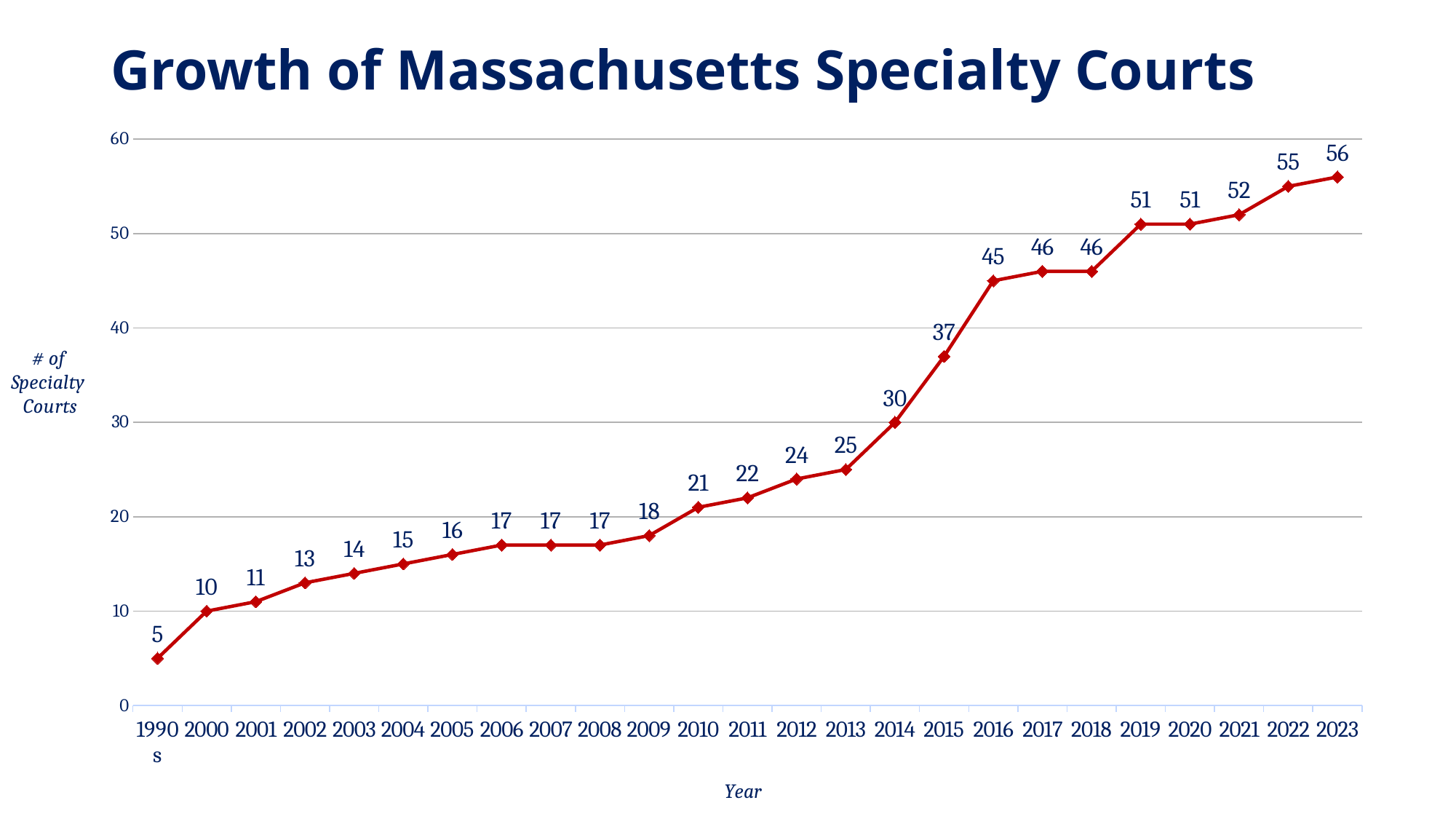
Which year has the lowest number of specialty courts? 1990s Does the number of specialty courts generally rise or fall from the 1990s to 2023? rise What is the number of specialty courts in 2010? 21 How many data points are plotted on the chart? 25 What is the number of specialty courts in 2016? 45 What kind of chart is shown on the slide? line chart What is the title of the chart? Growth of Massachusetts Specialty Courts What is the number of specialty courts in 2023? 56 Which year has more specialty courts, 2013 or 2019? 2019 Is the number of specialty courts in 2012 greater or less than 30? less Which year has the highest number of specialty courts? 2023 What is the difference in the number of specialty courts between 2015 and 2014? 7